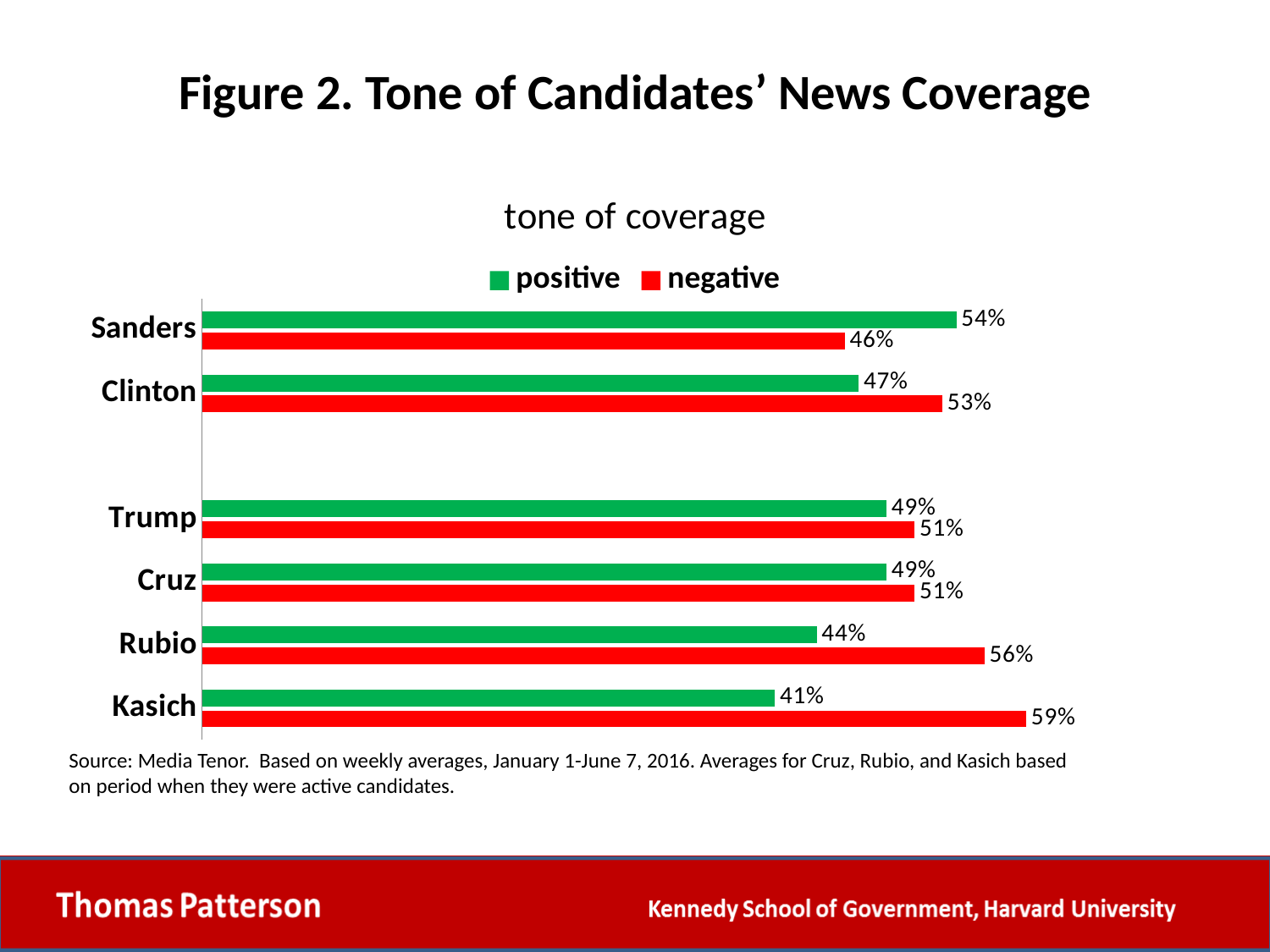
Which candidate has the highest negative coverage value? Kasich What is the difference between Kasich's negative and positive coverage values? 18% Which is larger for Clinton, the positive or the negative coverage value? negative What is the positive coverage value for Sanders? 54% How many candidates are shown on the chart? 6 What is the positive coverage value for Rubio? 44% What is the negative coverage value for Clinton? 53% How many series does the legend list? 2 What kind of chart is shown on the slide? bar chart Which candidate has the lowest positive coverage value? Kasich Which candidate has the highest positive coverage value? Sanders What is the negative coverage value for Kasich? 59%